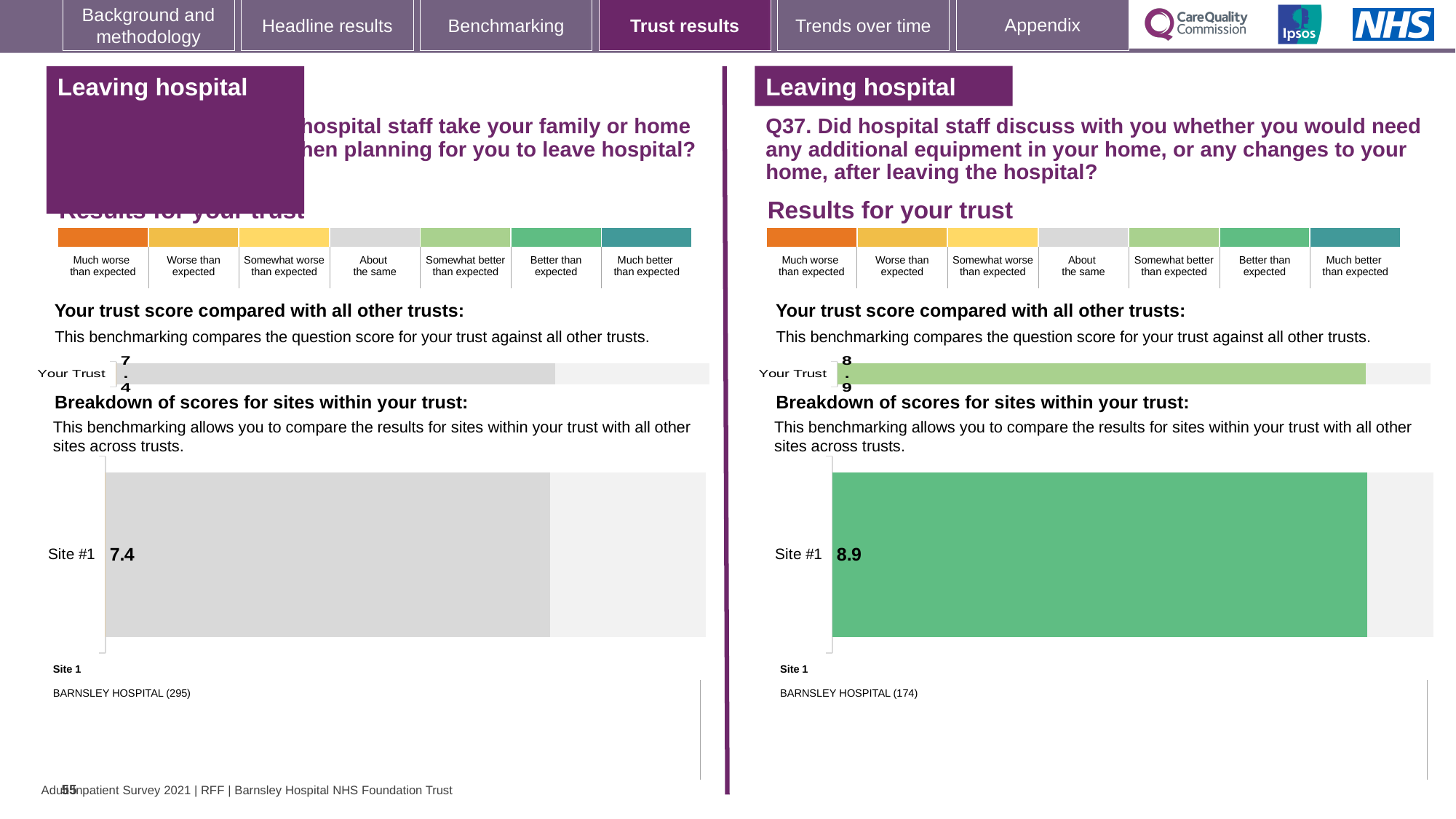
On the right half of the slide (Q37), which site name is listed as Site 1? BARNSLEY HOSPITAL (174) On the right half of the slide (Q37), what score is shown for Your Trust in the trust comparison bar? 8.9 On the left half of the slide, what score is shown for Your Trust in the trust comparison bar? 7.4 Which Site #1 score is larger: the one on the left half of the slide or the one on the right half (Q37)? The right half (Q37) On the right half of the slide (Q37), what is the score shown for Site #1? 8.9 On the left half of the slide, is the Site #1 score greater or less than 8? less How many sites are shown in the site breakdown chart on the right half of the slide (Q37)? 1 On the right half of the slide (Q37), is the Site #1 score greater or less than 8? greater On the left half of the slide, what is the score shown for Site #1? 7.4 What is the difference between the Site #1 score on the right half of the slide (Q37) and the Site #1 score on the left half? 1.5 What kind of chart is used to show the Site #1 score on the right half of the slide (Q37)? Bar chart On the left half of the slide, which site name is listed as Site 1? BARNSLEY HOSPITAL (295)